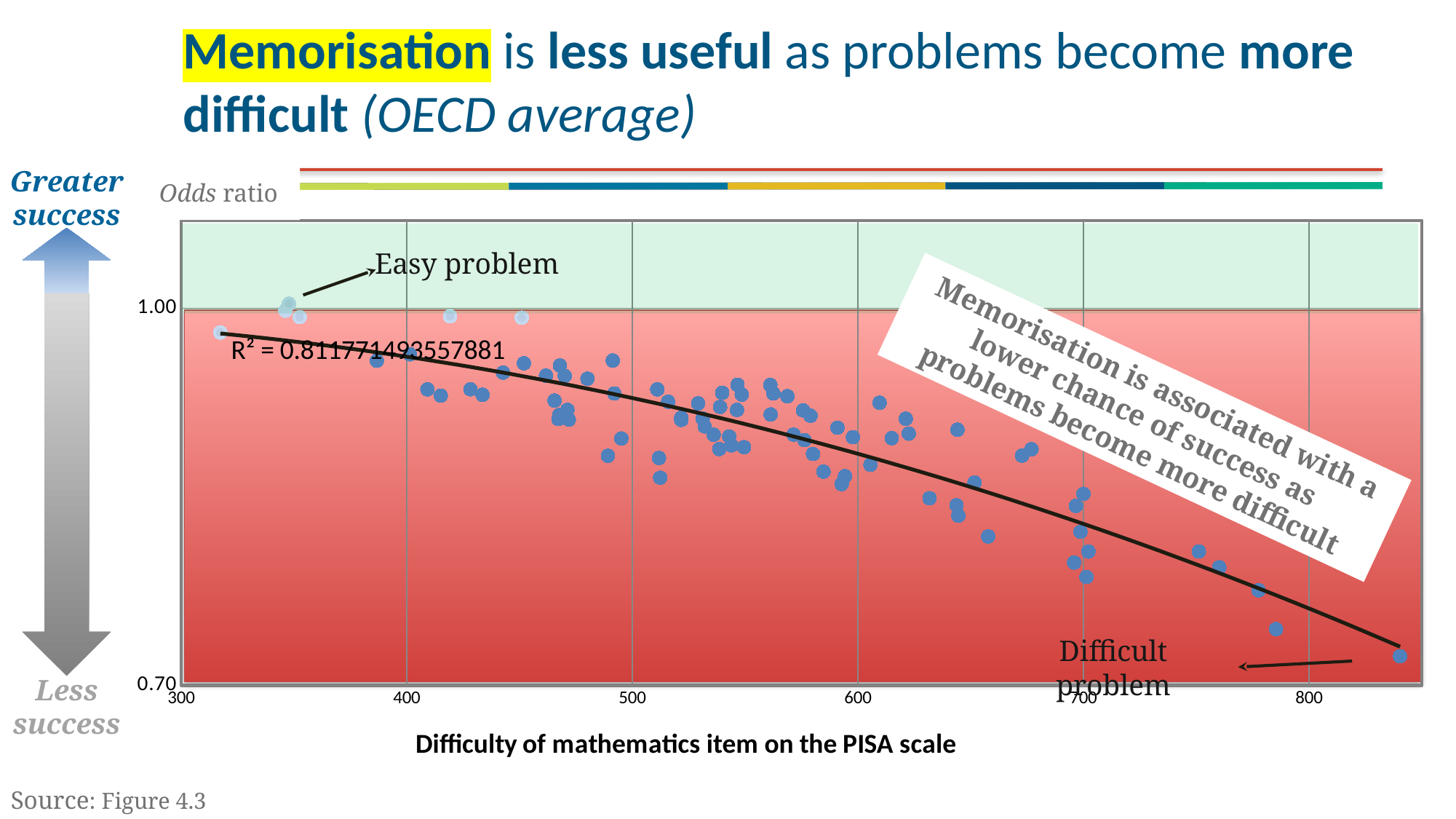
Is the odds ratio for the point labelled 'Difficult problem' greater or less than 1.00? less Is the odds ratio for the point labelled 'Difficult problem' greater or less than 0.70? greater What is the title of the x axis of the chart? Difficulty of mathematics item on the PISA scale What R² value is printed on the chart? R² = 0.811771493557881 What is the lowest value labelled on the y axis of the chart? 0.70 Do the odds ratio values rise or fall as the difficulty of the mathematics item increases along the x axis? Fall What is the lowest value shown on the x axis of the chart? 300 What kind of chart is shown on the slide? Scatter chart What is the highest value shown on the x axis of the chart? 800 What quantity is plotted on the y axis of the chart? Odds ratio Which labelled point has the higher odds ratio, the 'Easy problem' or the 'Difficult problem'? Easy problem